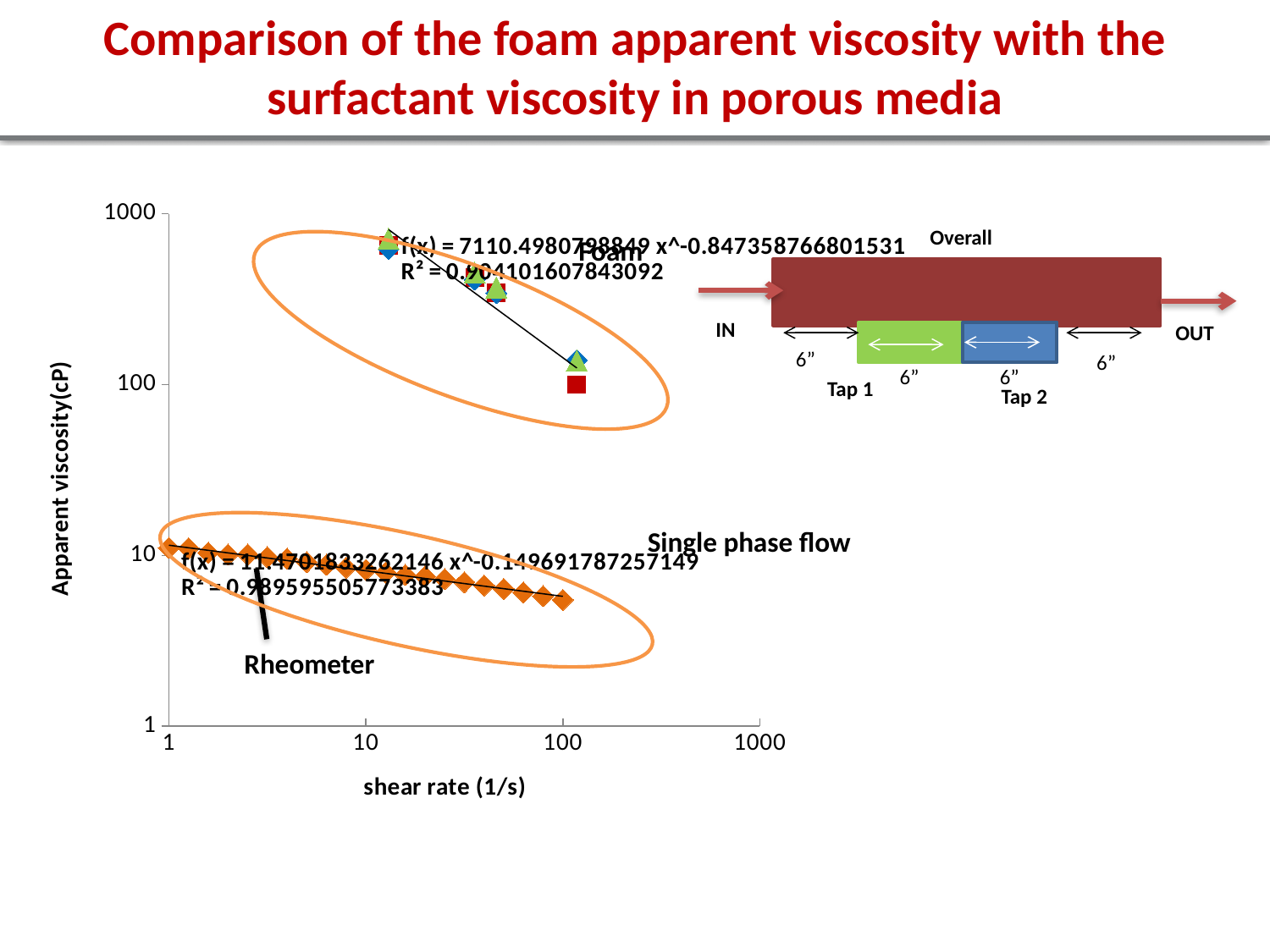
Does the apparent viscosity of the Foam points rise or fall as the shear rate increases? fall Which group of points has the higher apparent viscosity, Foam or Single phase flow? Foam Is the apparent viscosity of the Foam points at a shear rate of about 10 1/s greater or less than 100 cP? greater What is the highest tick value shown on the y axis of the chart? 1000 Is the apparent viscosity of the Foam points at a shear rate of about 10 1/s greater or less than 1000 cP? less Does the apparent viscosity of the Single phase flow points rise or fall as the shear rate increases? fall What is the title of the y axis of the chart? Apparent viscosity(cP) What is the title of the x axis of the chart? shear rate (1/s) What kind of chart is shown on the slide? scatter chart Is the apparent viscosity of the Single phase flow points at a shear rate of about 100 1/s greater or less than 10 cP? less